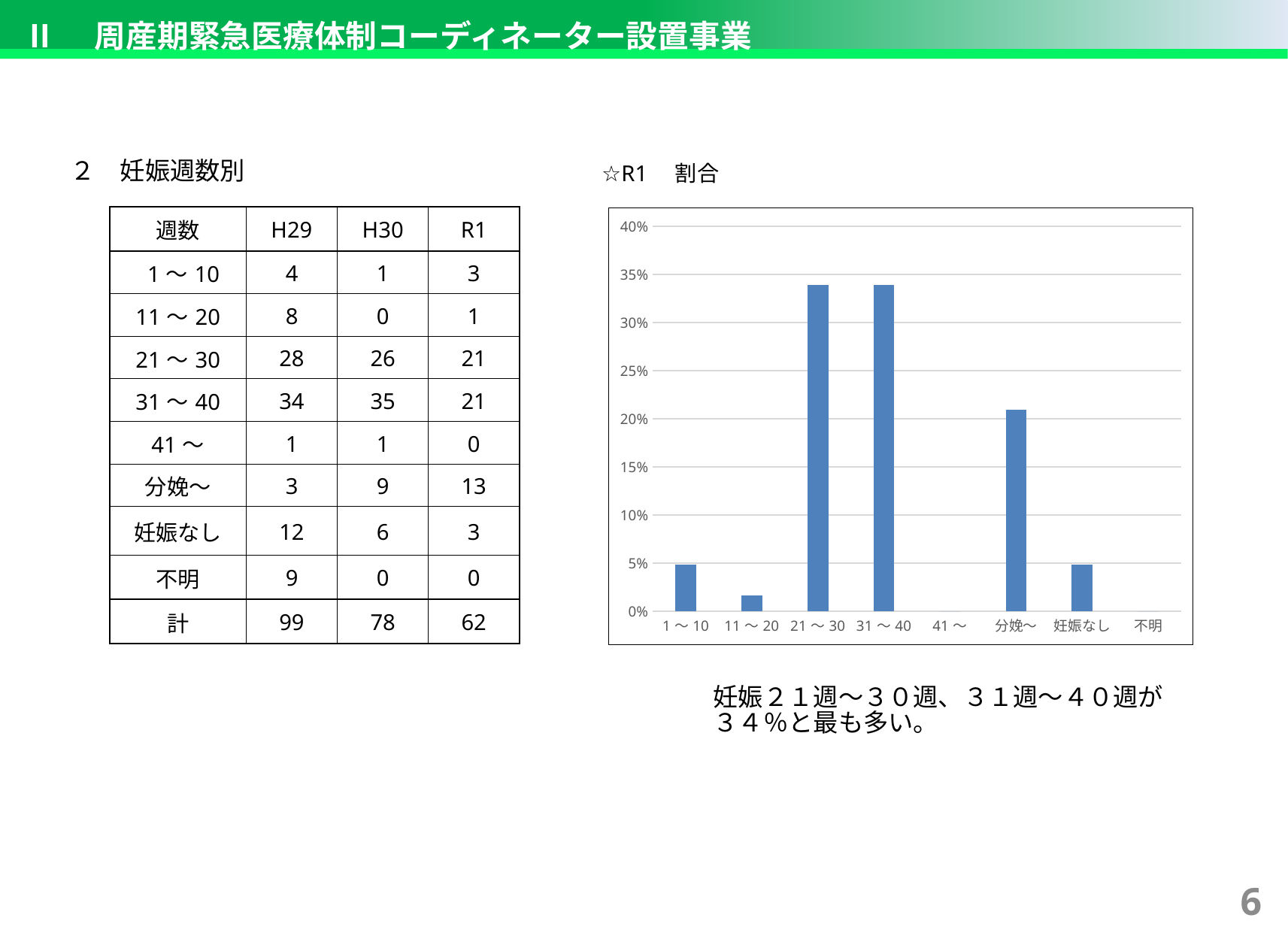
Is the value for 分娩～ greater or less than 15%? greater Which is larger, the value for 分娩～ or the value for 妊娠なし? 分娩～ Is the value for 分娩～ greater or less than 25%? less Which is larger, the value for 21～30 or the value for 分娩～? 21～30 How many categories are shown on the x axis of the chart? 8 Is the value for 21～30 greater or less than 30%? greater What kind of chart is shown on the slide? bar chart Which is larger, the value for 1～10 or the value for 11～20? 1～10 What is the highest value shown on the chart's vertical axis? 40%